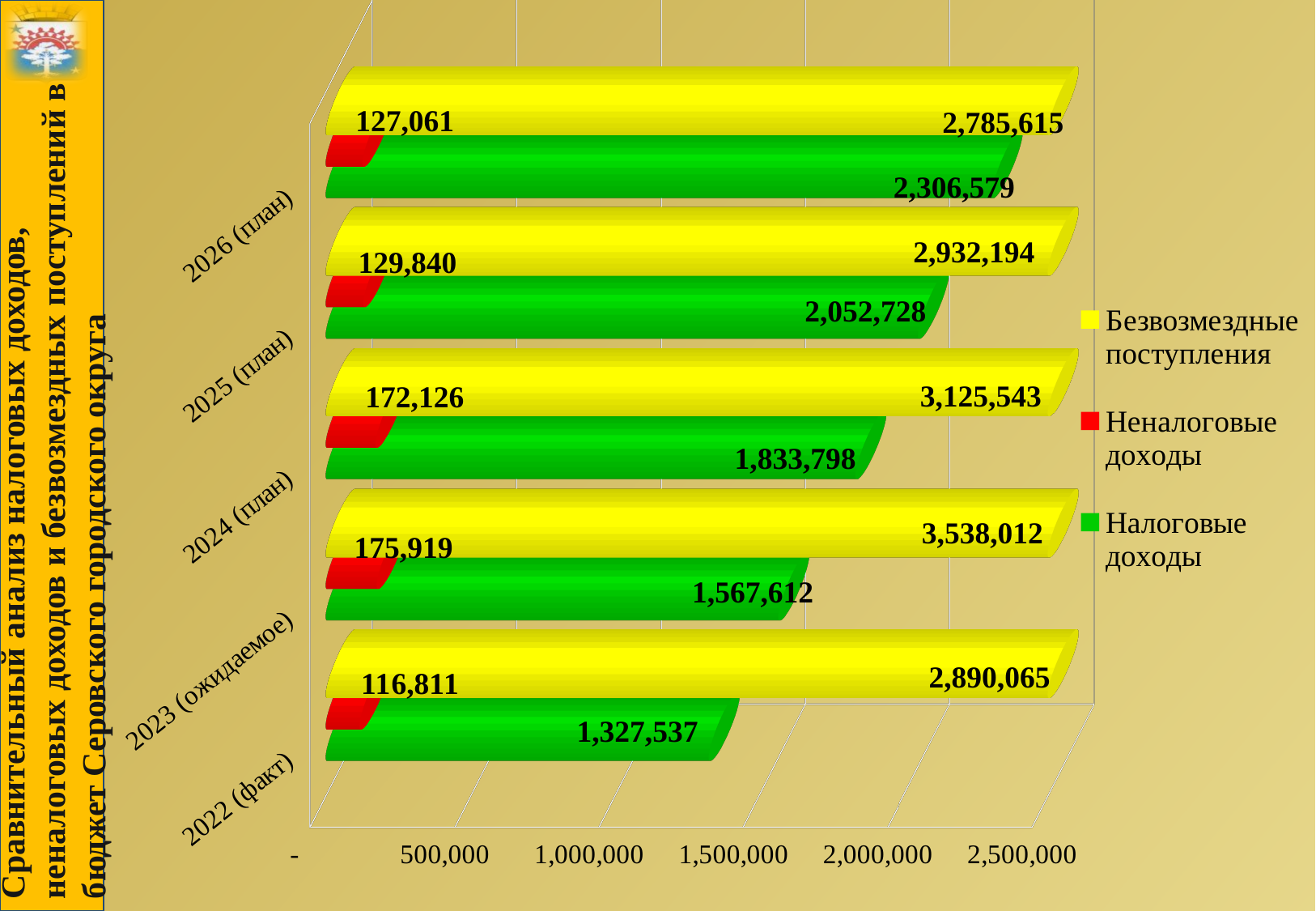
How many year categories are shown on the chart? 5 What is the difference between Налоговые доходы in 2026 (план) and 2025 (план)? 253,851 Which year has the lowest value of Неналоговые доходы? 2022 (факт) Which year has the highest value of Налоговые доходы? 2026 (план) Which is larger: Неналоговые доходы in 2023 (ожидаемое) or in 2024 (план)? 2023 (ожидаемое) What is the value of Неналоговые доходы for 2024 (план)? 172,126 What is the value of Налоговые доходы for 2025 (план)? 2,052,728 Which year has the highest value of Безвозмездные поступления? 2023 (ожидаемое) How many series does the legend list? 3 What is the value of Безвозмездные поступления for 2023 (ожидаемое)? 3,538,012 Do the values of Налоговые доходы rise or fall from 2022 (факт) to 2026 (план)? rise What is the value of Налоговые доходы for 2022 (факт)? 1,327,537